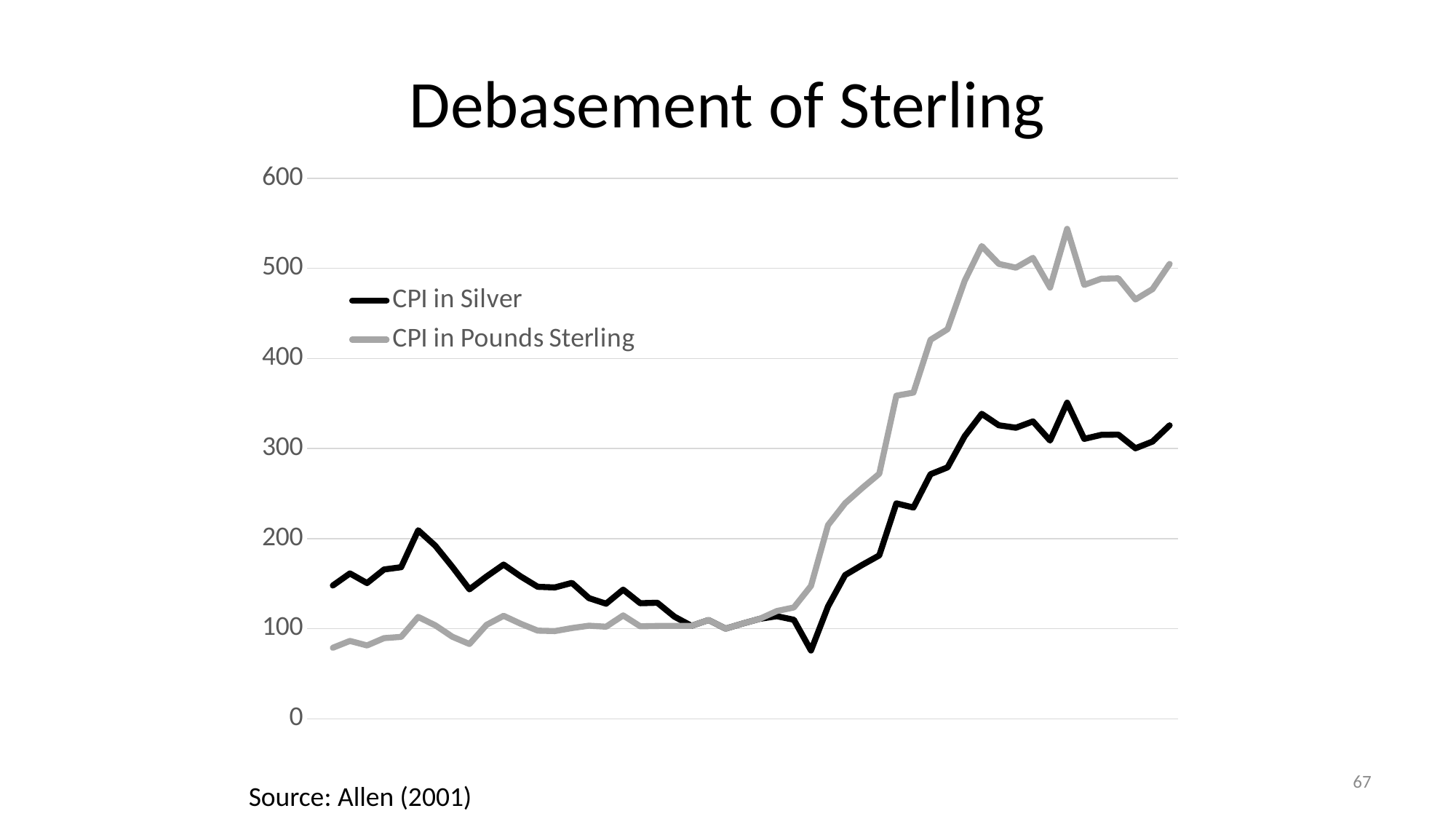
Is the lowest value of the CPI in Silver line greater or less than 100? less What is the title of the chart? Debasement of Sterling How many series does the legend list? 2 What kind of chart is shown on the slide? line chart Overall, does the CPI in Pounds Sterling line rise or fall from left to right? rise Is the highest value of the CPI in Silver line greater or less than 400? less At the right end of the chart, which series has the higher value, CPI in Silver or CPI in Pounds Sterling? CPI in Pounds Sterling Which series is drawn with the black line? CPI in Silver Which series reaches the highest value on the chart? CPI in Pounds Sterling Is the value of the CPI in Pounds Sterling line at the left end of the chart greater or less than 100? less At the left end of the chart, which series has the higher value, CPI in Silver or CPI in Pounds Sterling? CPI in Silver